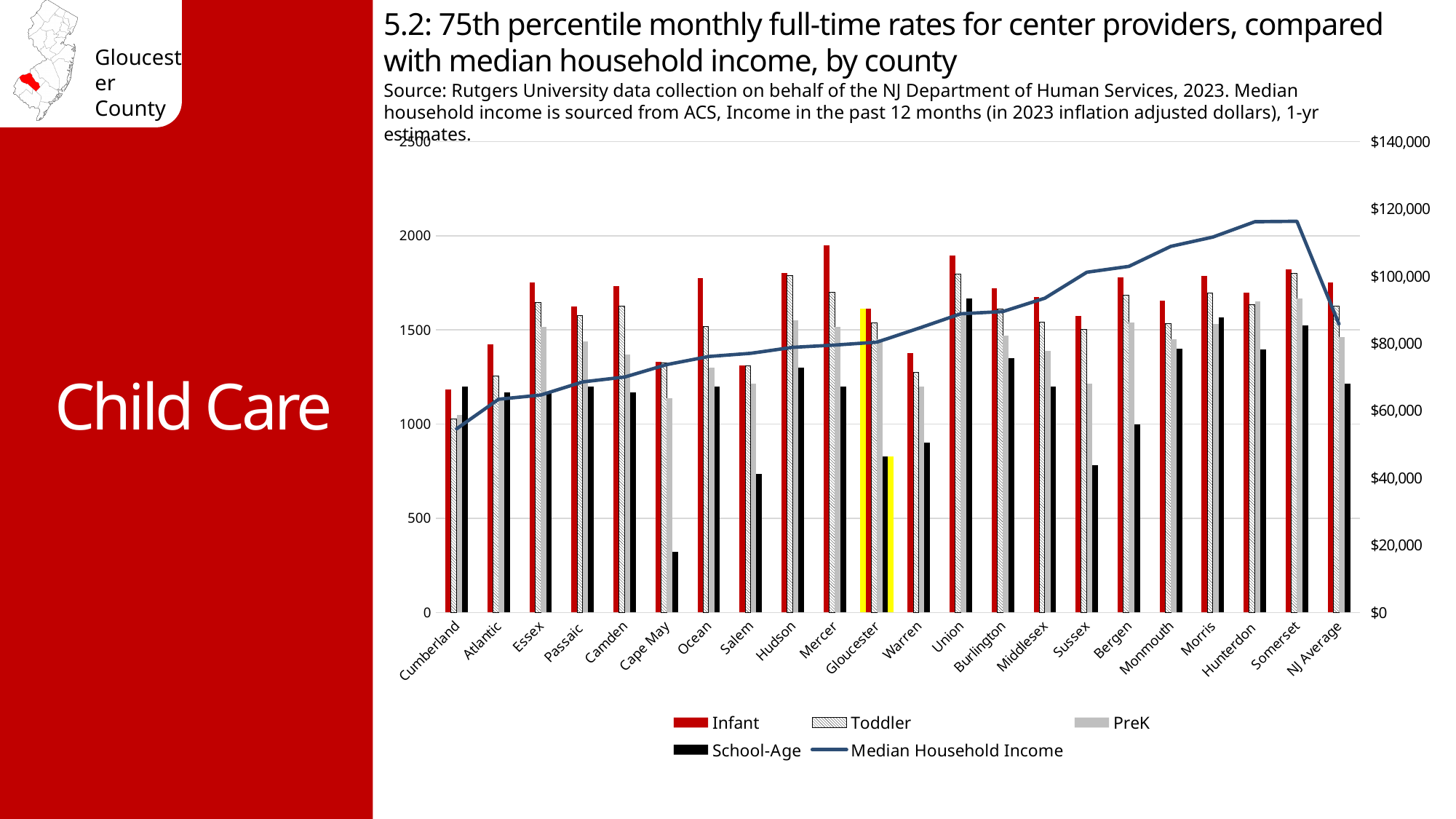
Which county's bars are highlighted in yellow? Gloucester How many categories are shown along the x axis? 22 Which category has the highest Infant rate? Mercer How many series does the legend list? 5 Does the Median Household Income line generally rise or fall from Cumberland to Somerset? rise What kind of chart is shown on the slide? Bar chart with a line Is the Median Household Income for Somerset greater or less than $100,000? greater Which category has the lowest School-Age rate? Cape May Is the Infant rate for Cumberland greater or less than 1500? less Which is larger, the Infant rate for Mercer or for Cumberland? Mercer Is the School-Age rate for Cape May greater or less than 500? less Which category has the lowest Infant rate? Cumberland